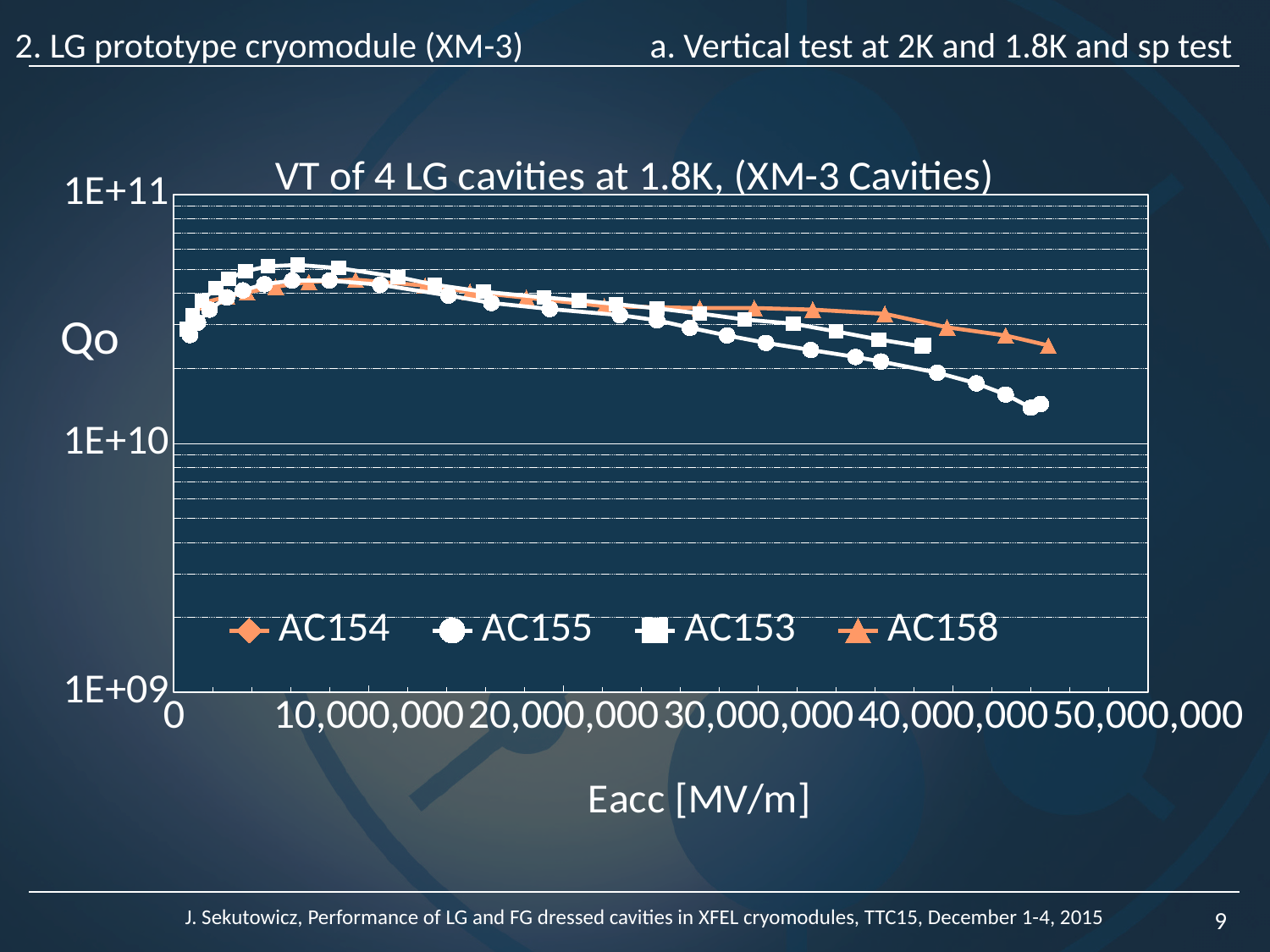
What kind of chart is shown on the slide? line chart Do the Qo values for AC155 rise or fall as Eacc increases beyond 10,000,000? fall Which series are listed in the legend? AC154, AC155, AC153, AC158 What is the title of the chart? VT of 4 LG cavities at 1.8K, (XM-3 Cavities) How many series does the legend list? 4 Which series has the lowest Qo at its final data point? AC155 Is the Qo value for AC158 at its highest Eacc point greater or less than 1E+10? greater Are all plotted Qo values greater or less than 1E+09? greater At an Eacc of about 40,000,000, which series has the higher Qo, AC158 or AC155? AC158 Is the Qo value for AC155 at its highest Eacc point greater or less than 1E+10? greater What is the label of the x axis? Eacc [MV/m]